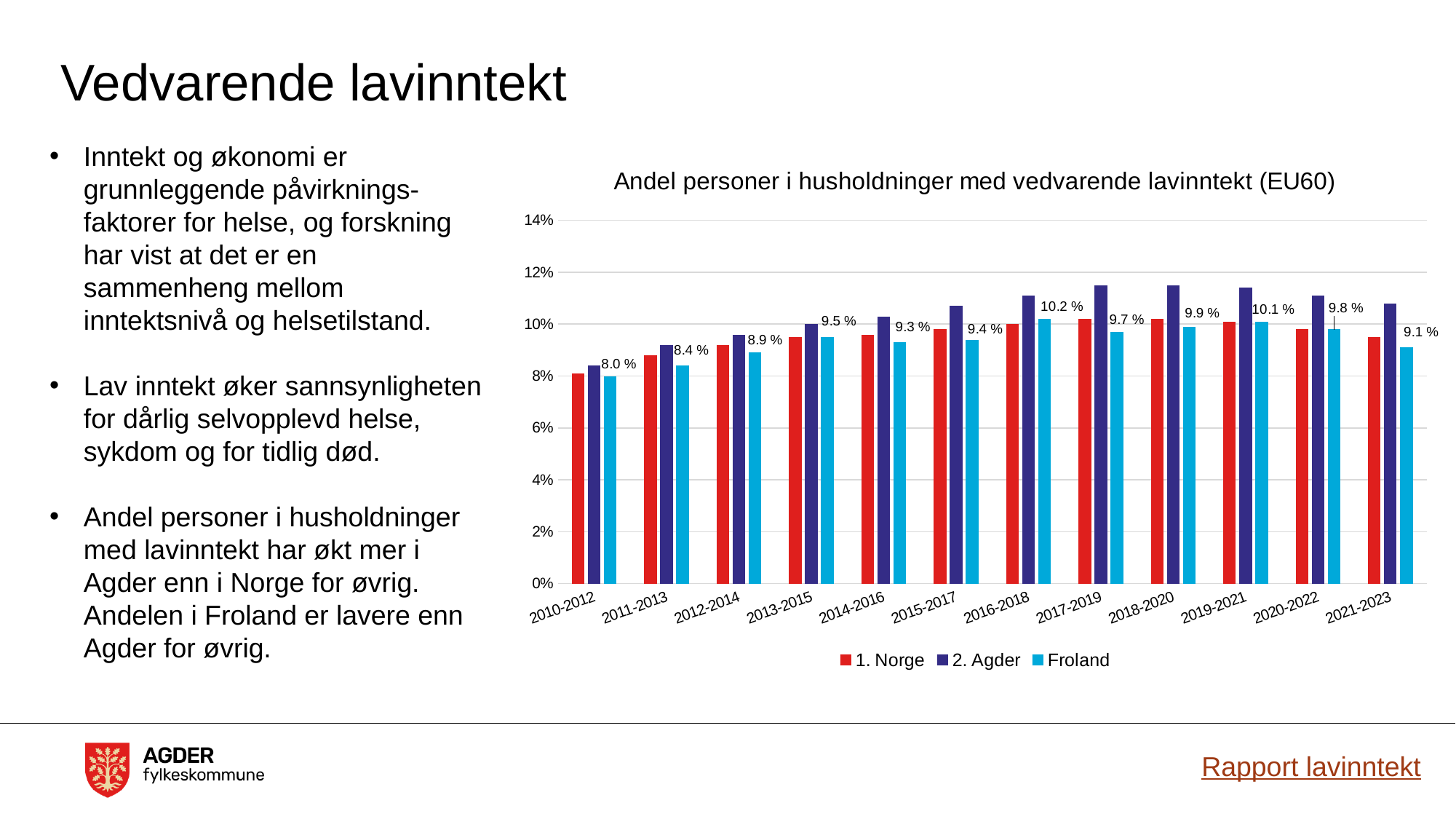
In which period is the Froland value highest? 2016-2018 What is the difference between the Froland values for 2016-2018 and 2010-2012? 2.2 percentage points In which period is the Froland value lowest? 2010-2012 Is the value for 1. Norge in 2010-2012 greater or less than 10%? less Is the value for 2. Agder in 2017-2019 greater or less than 10%? greater How many series does the legend list? 3 Which is larger, the Froland value for 2019-2021 or for 2021-2023? 2019-2021 What kind of chart is shown on the slide? Bar chart How many periods are shown on the x axis? 12 What is the value for Froland in 2010-2012? 8.0 % What is the value for Froland in 2021-2023? 9.1 % What is the value for Froland in 2016-2018? 10.2 %